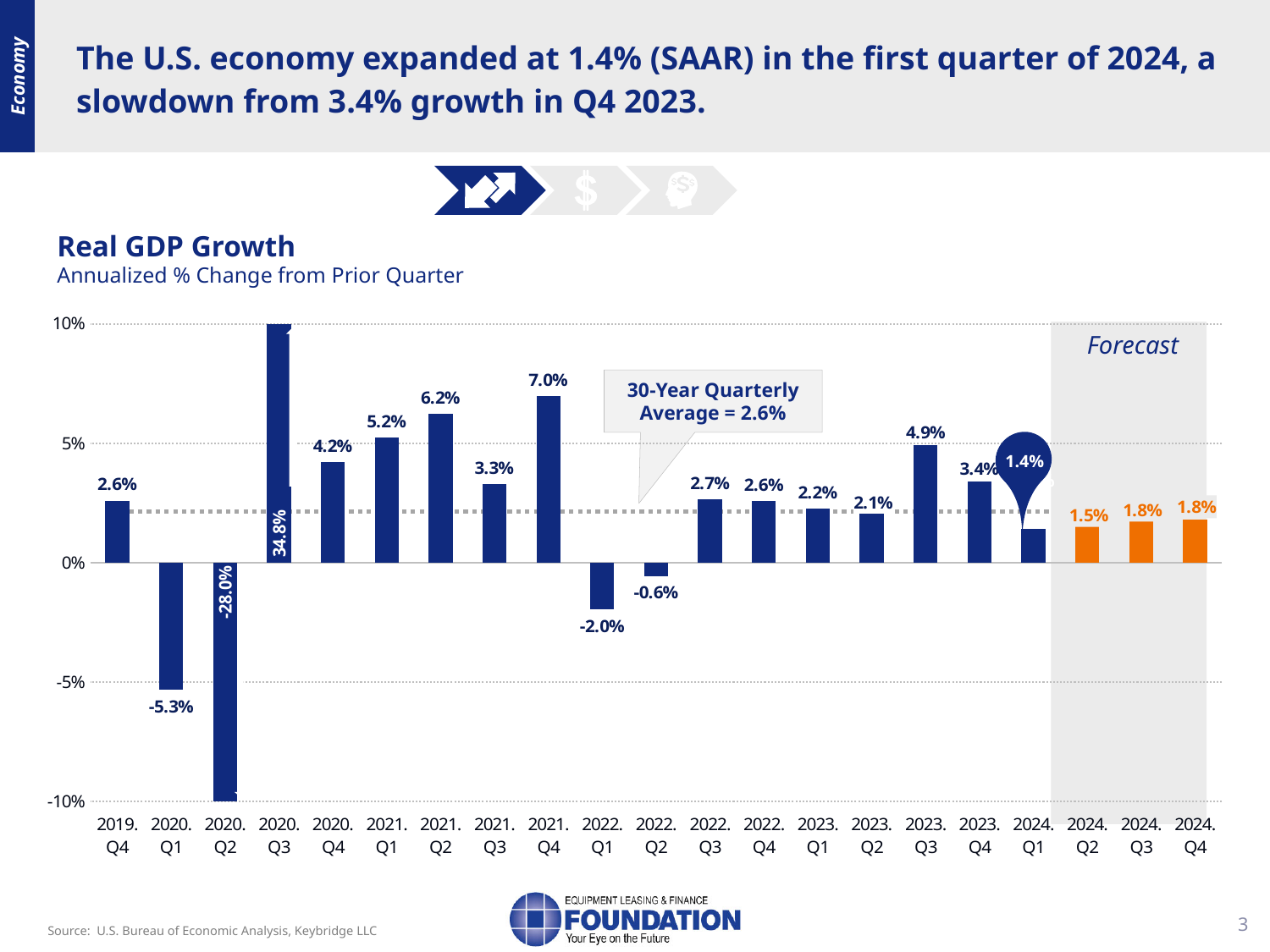
What is the 30-Year Quarterly Average shown on the Real GDP Growth chart? 2.6% What is the subtitle of the Real GDP Growth chart? Annualized % Change from Prior Quarter Which quarter has the highest Real GDP Growth value? 2020 Q3 What is the difference between the Real GDP Growth values for 2023 Q4 and 2024 Q1? 2.0% Which is larger, the Real GDP Growth value for 2021 Q2 or for 2021 Q3? 2021 Q2 What is the forecast Real GDP Growth value for 2024 Q2? 1.5% What kind of chart is the Real GDP Growth chart? bar chart Which quarter has the lowest Real GDP Growth value? 2020 Q2 How many quarters are shown on the x axis of the Real GDP Growth chart? 21 What is the Real GDP Growth value for 2021 Q4? 7.0% Is the Real GDP Growth value for 2023 Q3 greater or less than 5%? less What is the Real GDP Growth value for 2020 Q2? -28.0%